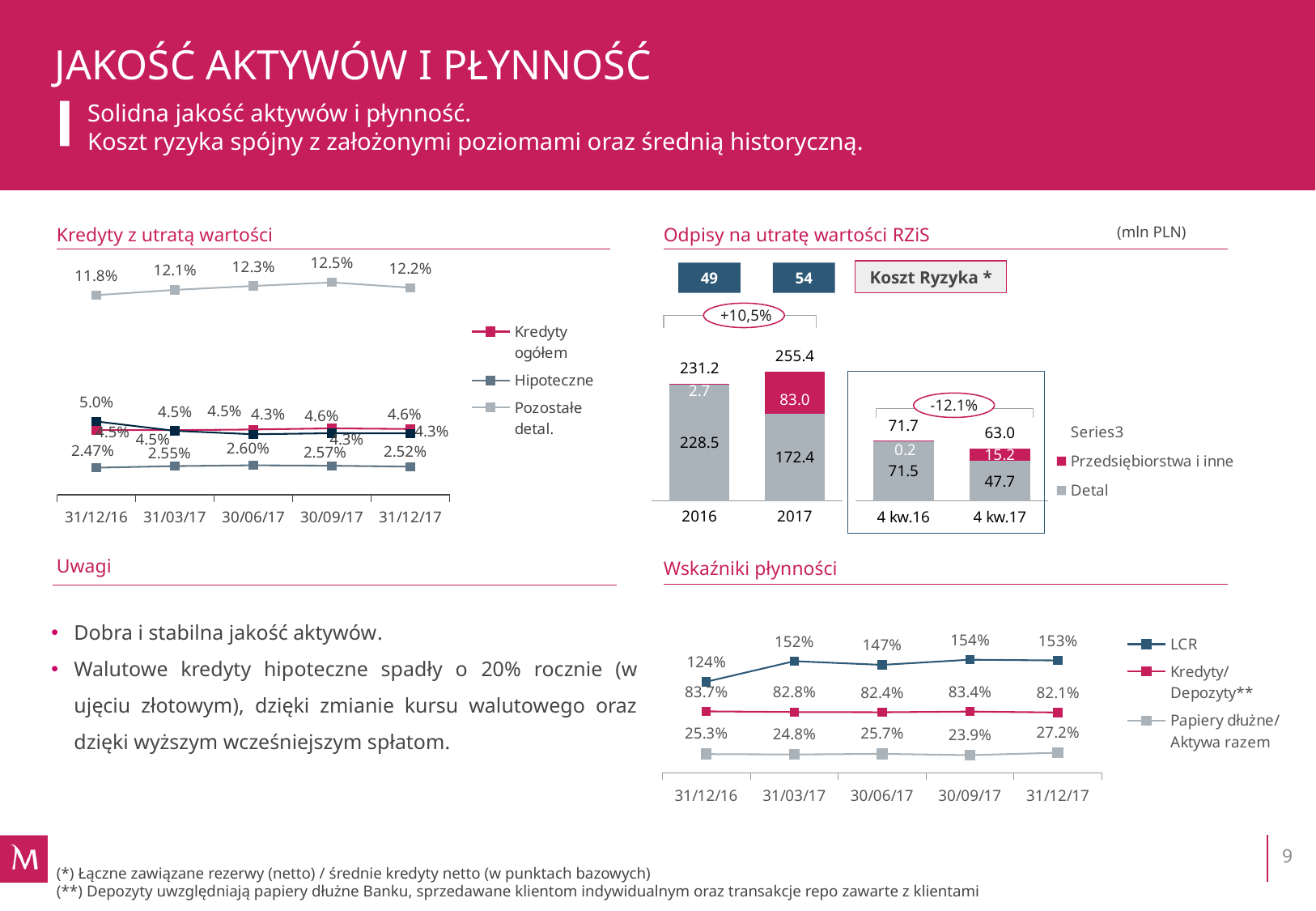
In the 'Wskaźniki płynności' chart, which is larger at 30/06/17: LCR or Kredyty/Depozyty? LCR In the 'Wskaźniki płynności' chart, what is the LCR value at 31/12/16? 124% In the 'Odpisy na utratę wartości RZiS' chart, what is the Przedsiębiorstwa i inne value for 4 kw.17? 15.2 In the 'Wskaźniki płynności' chart, what is the Papiery dłużne/Aktywa razem value at 31/12/17? 27.2% In the 'Wskaźniki płynności' chart, at which date is LCR highest? 30/09/17 In the 'Kredyty z utratą wartości' chart, what is the value for Pozostałe detal at 30/09/17? 12.5% In the 'Odpisy na utratę wartości RZiS' chart, what is the difference between the Detal values for 2016 and 2017? 56.1 In the 'Kredyty z utratą wartości' chart, how many dates are shown on the x axis? 5 In the 'Odpisy na utratę wartości RZiS' chart, what is the Detal value for 2017? 172.4 In the 'Odpisy na utratę wartości RZiS' chart, what is the total of the stacked bar for 2016? 231.2 In the 'Kredyty z utratą wartości' chart, how many series does the legend list? 3 In the 'Odpisy na utratę wartości RZiS' chart, what kind of chart is used? Stacked bar chart